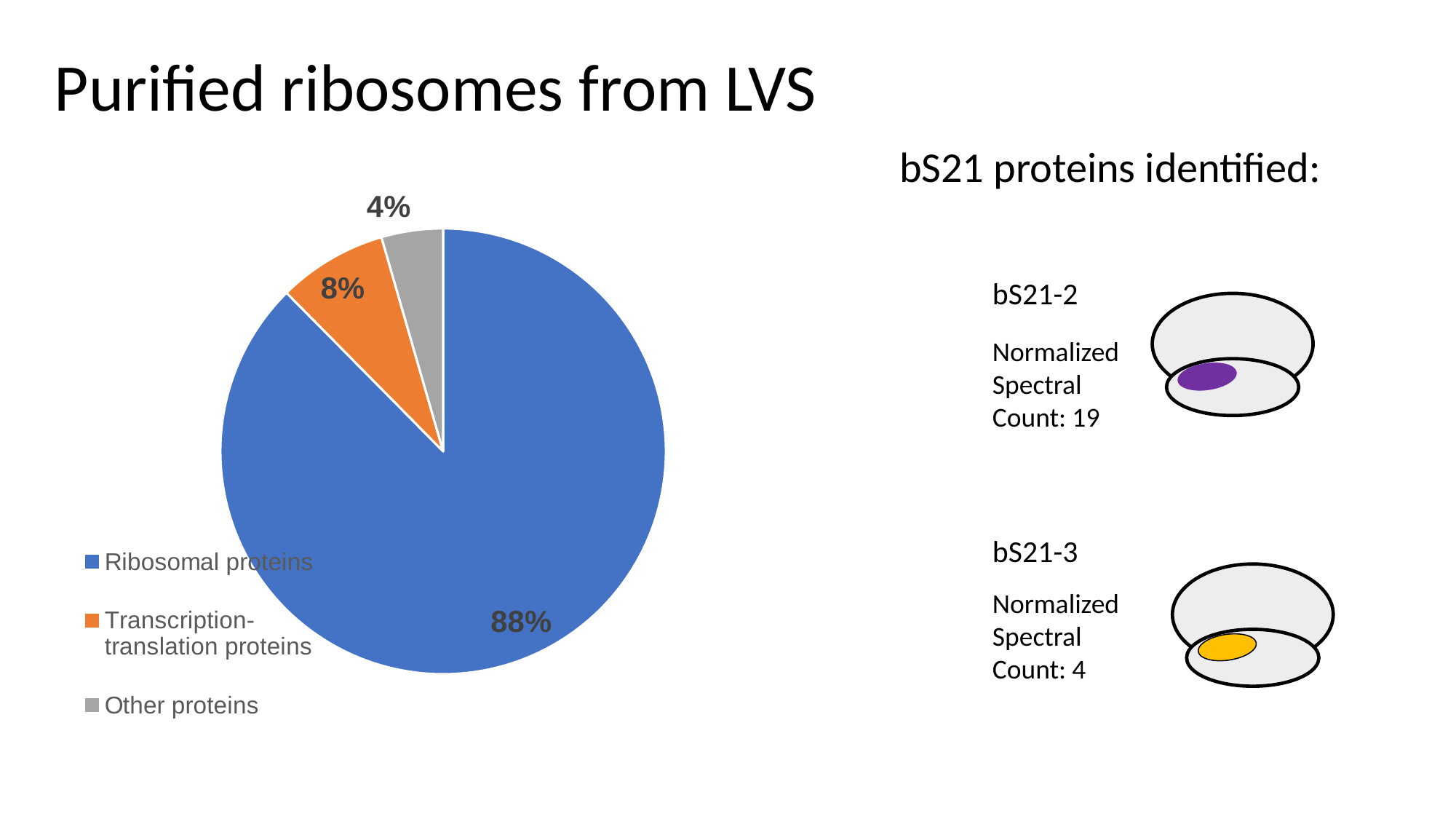
What is the difference in percentage points between Ribosomal proteins and Transcription-translation proteins? 80 What colour is the slice for Other proteins? grey How many categories does the pie chart show? 3 What share of the pie is Ribosomal proteins? 88% What is the difference in percentage points between Transcription-translation proteins and Other proteins? 4 Which is larger, the share for Transcription-translation proteins or the share for Other proteins? Transcription-translation proteins Which category has the largest slice of the pie? Ribosomal proteins Which category has the smallest slice of the pie? Other proteins What share of the pie is Other proteins? 4% What kind of chart is shown on the slide? pie chart How many entries does the legend list? 3 What share of the pie is Transcription-translation proteins? 8%